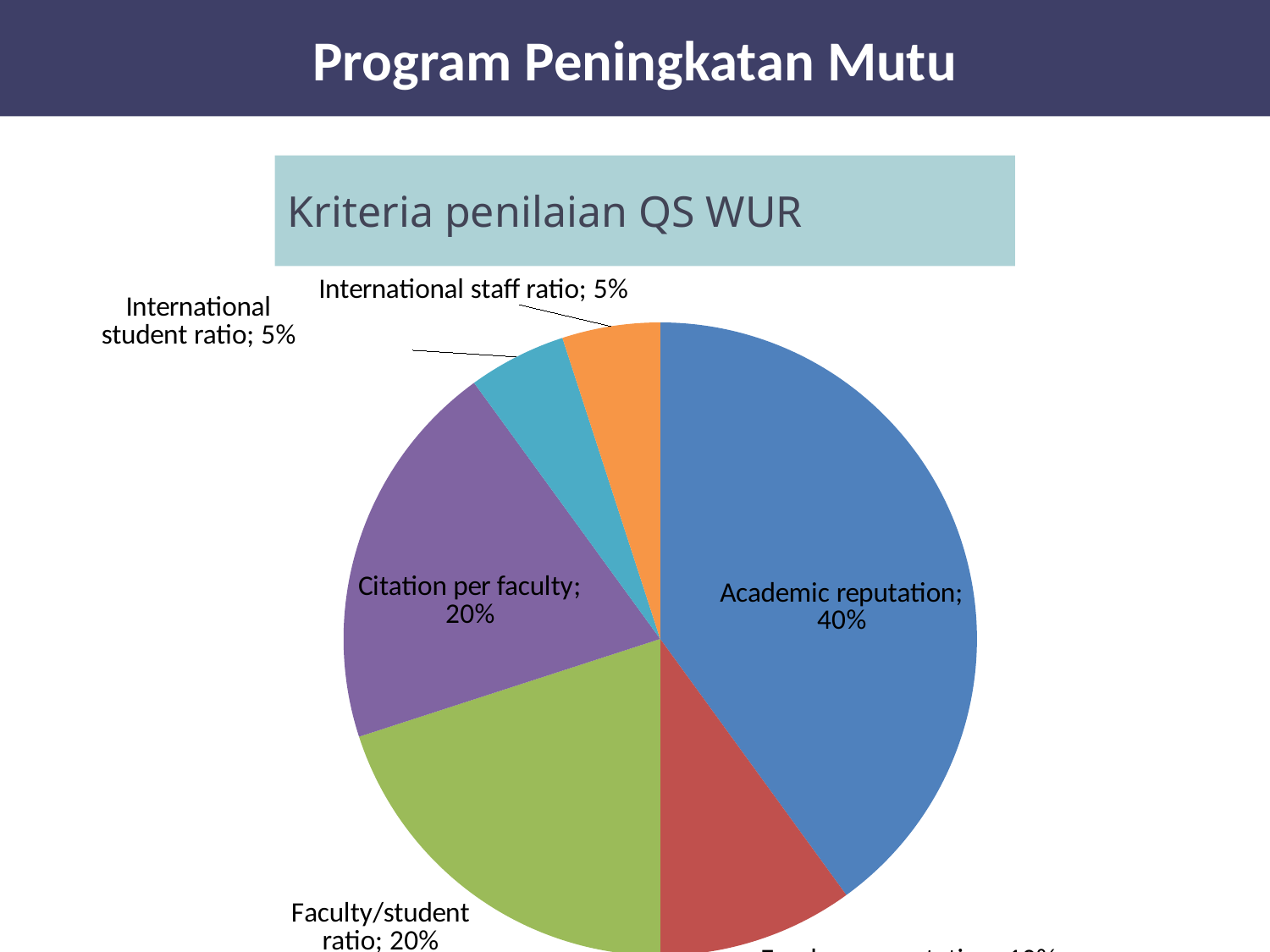
What is the value shown for International staff ratio? 5% Which criterion has the largest slice of the pie? Academic reputation What is the value shown for Faculty/student ratio? 20% What is the title of the chart? Kriteria penilaian QS WUR What is the value shown for Citation per faculty? 20% Which is larger, the share for Academic reputation or the share for Faculty/student ratio? Academic reputation What is the difference between the Citation per faculty share and the International staff ratio share? 15 percentage points What share of the pie does Academic reputation have? 40% What is the value shown for International student ratio? 5% What kind of chart is shown on the slide? Pie chart How many slices does the pie chart have? 6 What is the difference between the Academic reputation share and the Citation per faculty share? 20 percentage points